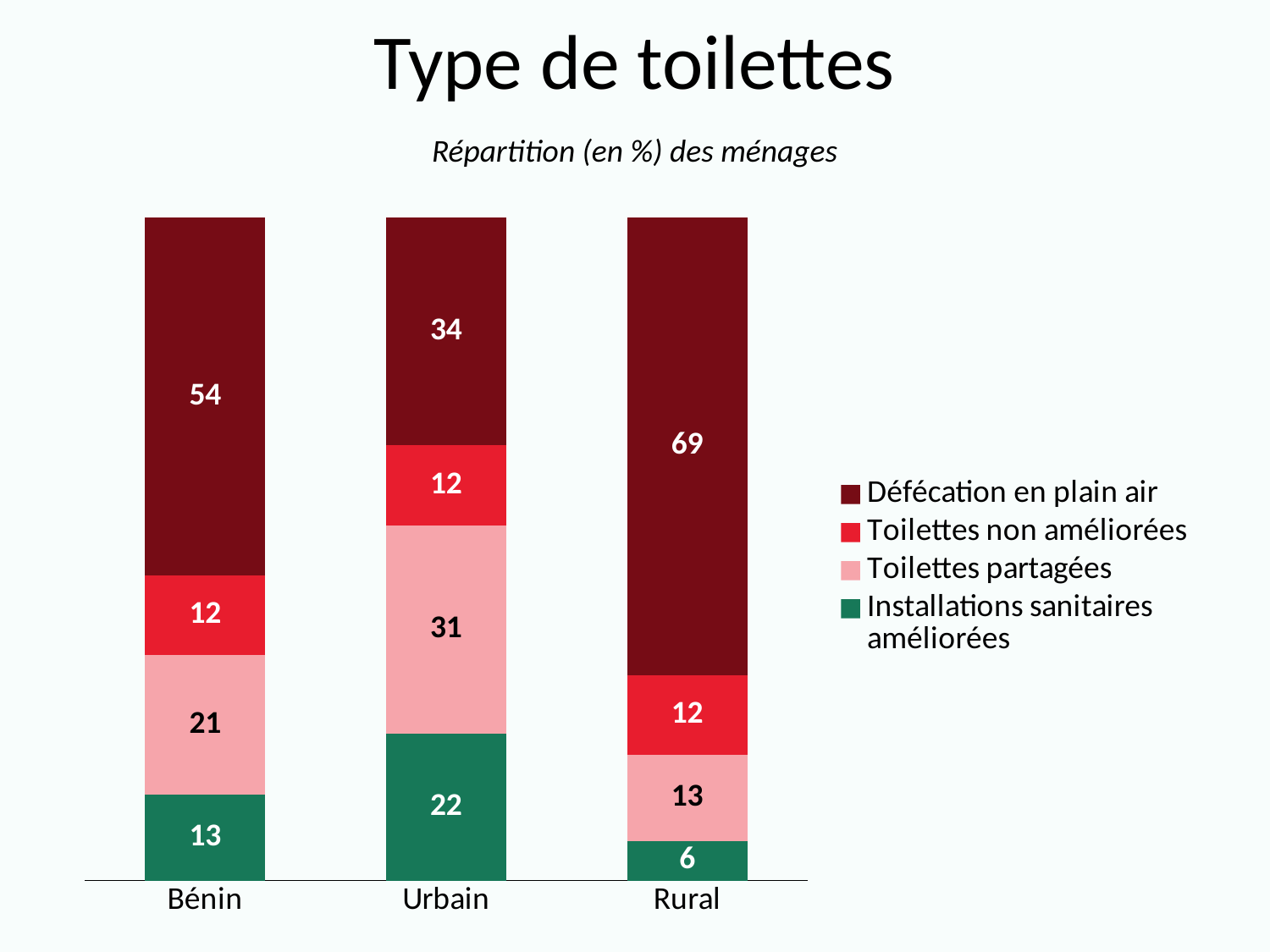
What is the value for Toilettes partagées in Bénin? 21 Which category has the highest value for Défécation en plain air? Rural What is the value for Installations sanitaires améliorées in Urbain? 22 What is the difference between the Défécation en plain air values for Rural and Urbain? 35 Which is larger, the Toilettes partagées value for Urbain or for Rural? Urbain What is the title of the chart? Type de toilettes What is the total of the stacked bar for Urbain? 99 Which category has the lowest value for Installations sanitaires améliorées? Rural What is the value for Défécation en plain air in Rural? 69 How many series does the legend list? 4 What kind of chart is shown on the slide? stacked bar chart How many categories are shown on the x axis? 3